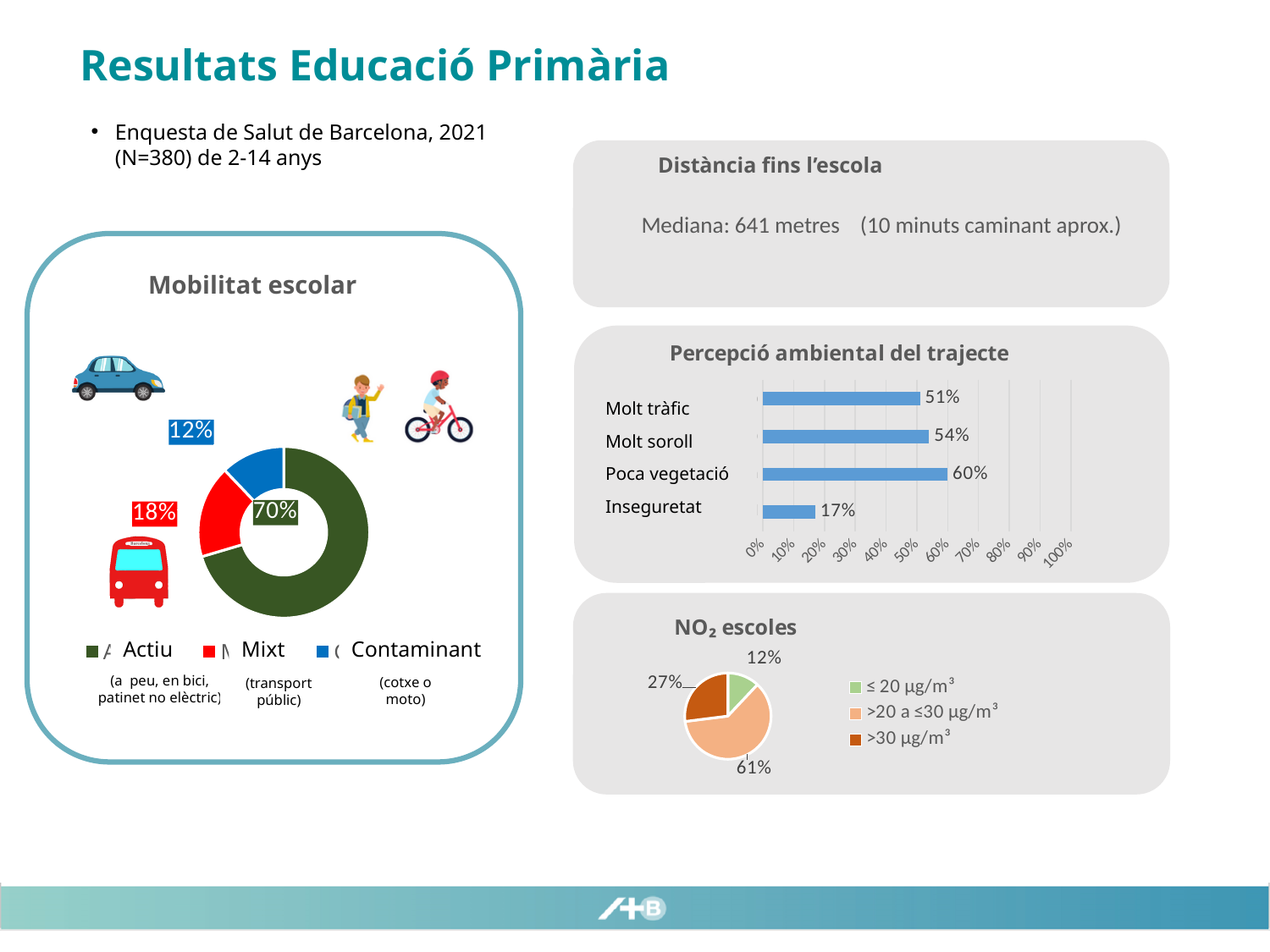
In the 'Mobilitat escolar' chart, which category has the smallest share? Contaminant How many categories are shown in the 'Percepció ambiental del trajecte' chart? 4 In the 'Mobilitat escolar' chart, what is the difference between the Actiu and Contaminant shares? 58% In the 'Mobilitat escolar' chart, what percentage is shown for Mixt? 18% In the 'NO₂ escoles' chart, what share is shown for '>20 a ≤30 µg/m³'? 61% In the 'Mobilitat escolar' chart, what percentage is shown for Actiu? 70% In the 'Percepció ambiental del trajecte' chart, what is the value for Poca vegetació? 60% In the 'Percepció ambiental del trajecte' chart, which category has the highest value? Poca vegetació What kind of chart is 'Percepció ambiental del trajecte'? Bar chart In the 'Percepció ambiental del trajecte' chart, which is larger: Molt tràfic or Molt soroll? Molt soroll In the 'Percepció ambiental del trajecte' chart, what is the value for Inseguretat? 17% In the 'NO₂ escoles' chart, what is the difference between the '>30 µg/m³' and '≤ 20 µg/m³' slices? 15%